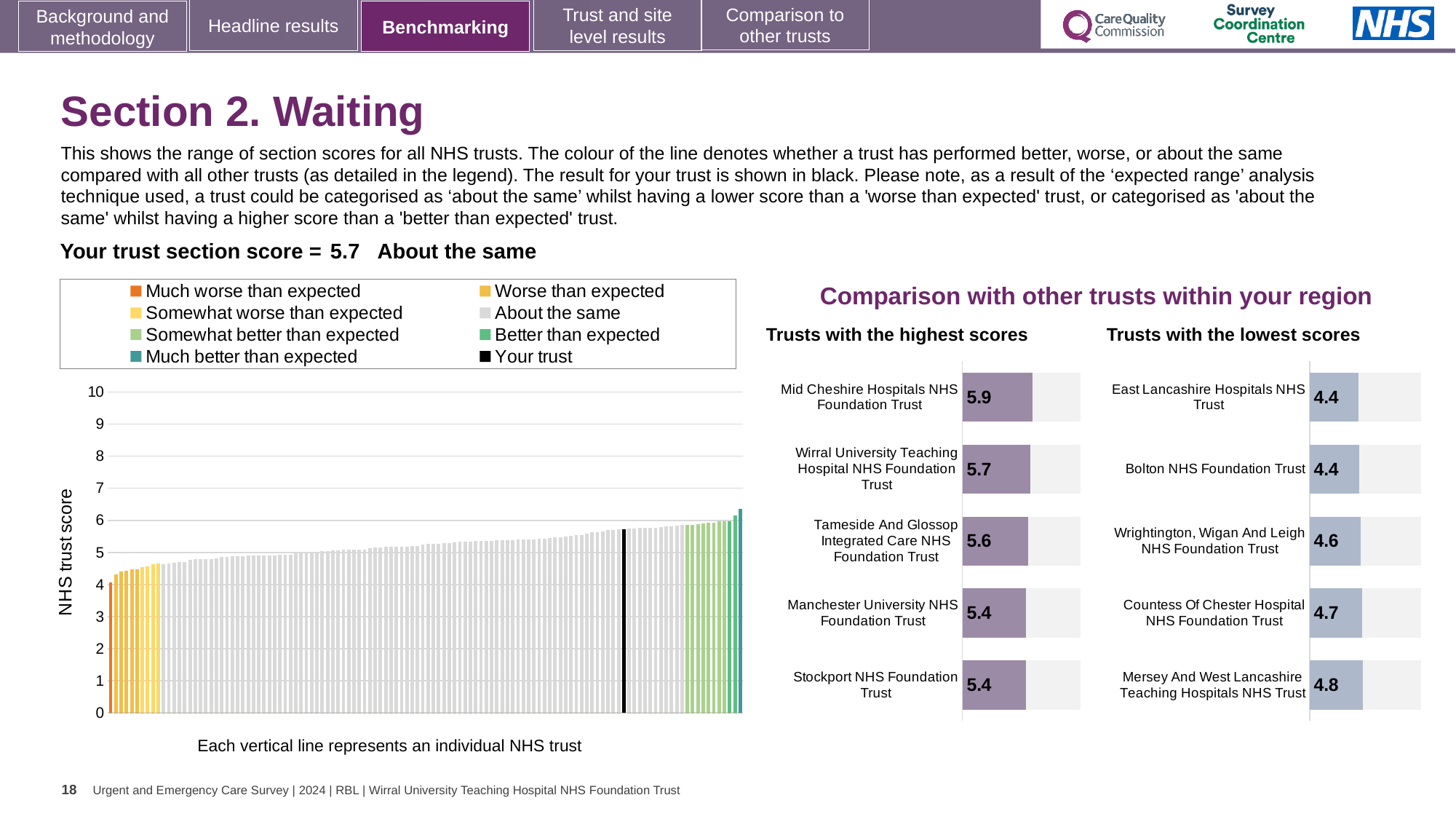
In the 'Trusts with the highest scores' chart, which trust has the highest score? Mid Cheshire Hospitals NHS Foundation Trust In the 'Trusts with the lowest scores' chart, what is the difference between the scores of Mersey And West Lancashire Teaching Hospitals NHS Trust and Bolton NHS Foundation Trust? 0.4 In the 'Trusts with the highest scores' chart, what is the difference between the scores of Mid Cheshire Hospitals NHS Foundation Trust and Stockport NHS Foundation Trust? 0.5 What kind of chart is the large chart on the left showing the range of NHS trust scores? Bar chart In the 'Trusts with the lowest scores' chart, which has the higher score: Wrightington, Wigan And Leigh NHS Foundation Trust or Countess Of Chester Hospital NHS Foundation Trust? Countess Of Chester Hospital NHS Foundation Trust How many entries does the legend of the large chart on the left list? 8 In the large chart on the left, is the value of the black bar (your trust) greater or less than 5? greater In the 'Trusts with the lowest scores' chart, what is the score for Countess Of Chester Hospital NHS Foundation Trust? 4.7 In the 'Trusts with the highest scores' chart, what is the score for Mid Cheshire Hospitals NHS Foundation Trust? 5.9 In the 'Trusts with the highest scores' chart, what is the score for Tameside And Glossop Integrated Care NHS Foundation Trust? 5.6 In the 'Trusts with the lowest scores' chart, which trust has the highest score? Mersey And West Lancashire Teaching Hospitals NHS Trust How many trusts are shown in the 'Trusts with the lowest scores' chart? 5